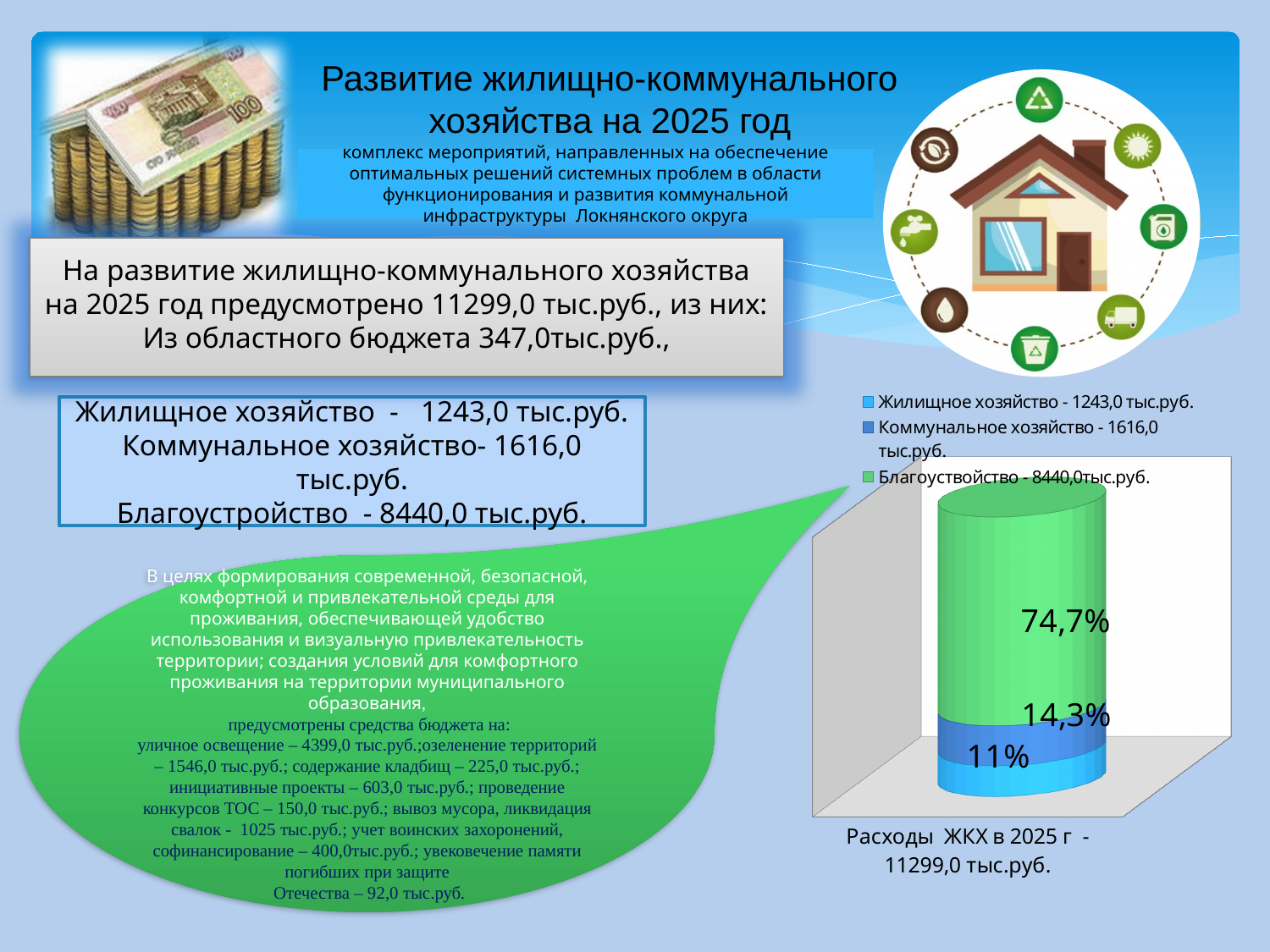
Which series has the smallest share of the stacked bar? Жилищное хозяйство What is the difference between the shares of Благоустройство and Коммунальное хозяйство? 60,4% Which series has the largest share of the stacked bar? Благоустройство What share of the stacked bar is labelled for Коммунальное хозяйство? 14,3% What colour is the Благоустройство segment of the bar? Green What share of the stacked bar is labelled for Благоустройство? 74,7% How many series does the chart legend list? 3 Which is larger, the share of Коммунальное хозяйство or the share of Жилищное хозяйство? Коммунальное хозяйство What kind of chart is shown on the slide? Stacked bar chart What share of the stacked bar is labelled for Жилищное хозяйство? 11% What is the difference between the shares of Коммунальное хозяйство and Жилищное хозяйство? 3,3% What is the total of the three labelled shares in the stacked bar? 100%